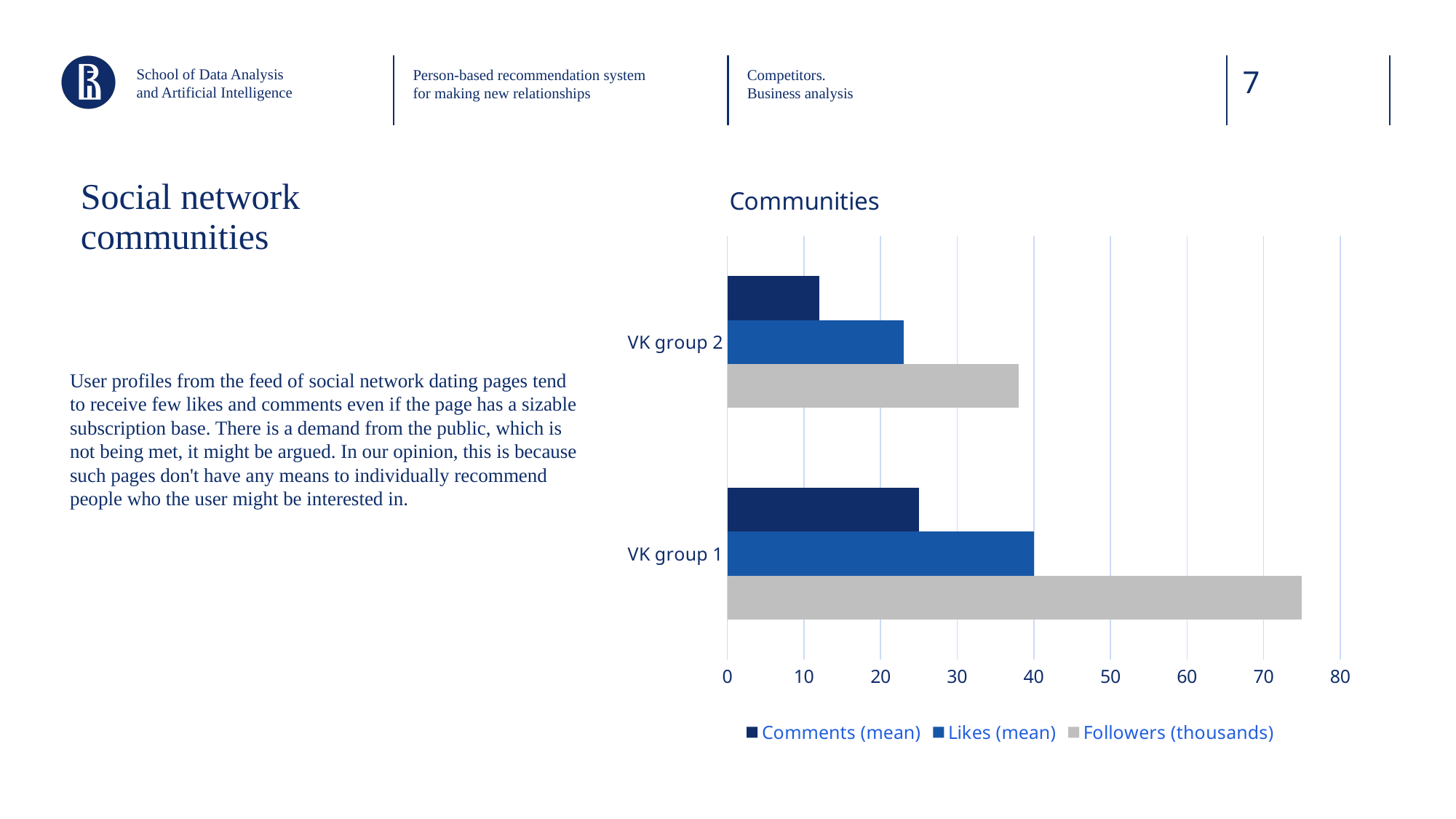
Which category has the highest Followers (thousands) value? VK group 1 Is the Followers (thousands) value for VK group 1 greater or less than 70? greater Is the Comments (mean) value for VK group 2 greater or less than 20? less How many series does the chart's legend list? 3 Which category has the lowest Comments (mean) value? VK group 2 What is the title of the chart? Communities Which is larger: Likes (mean) for VK group 1 or Likes (mean) for VK group 2? VK group 1 Which series is shown in grey in the legend? Followers (thousands) How many categories are shown on the chart? 2 Is the Followers (thousands) value for VK group 2 greater or less than 40? less What kind of chart is shown on the slide? bar chart